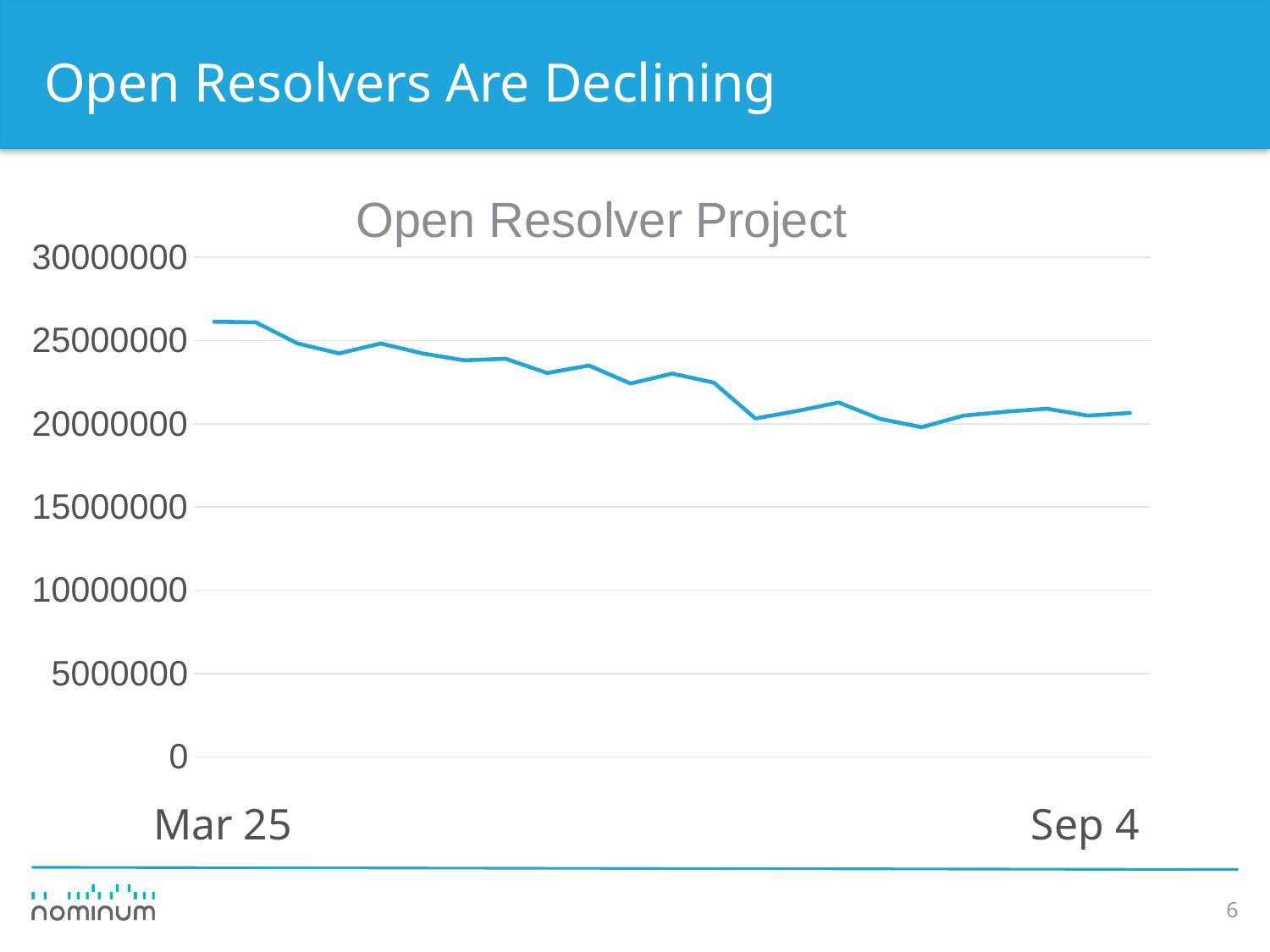
What is the highest value shown on the vertical axis? 30000000 What kind of chart is shown on the slide? line chart Is the value at the start of the line (Mar 25) greater or less than 25000000? greater What date label appears at the right end of the horizontal axis? Sep 4 Is the lowest value on the line greater or less than 15000000? greater Is the value at the end of the line (Sep 4) greater or less than 25000000? less What date label appears at the left end of the horizontal axis? Mar 25 Do the values in the chart generally rise or fall from Mar 25 to Sep 4? fall Which is larger, the value at Mar 25 or the value at Sep 4? Mar 25 What is the title of the chart? Open Resolver Project